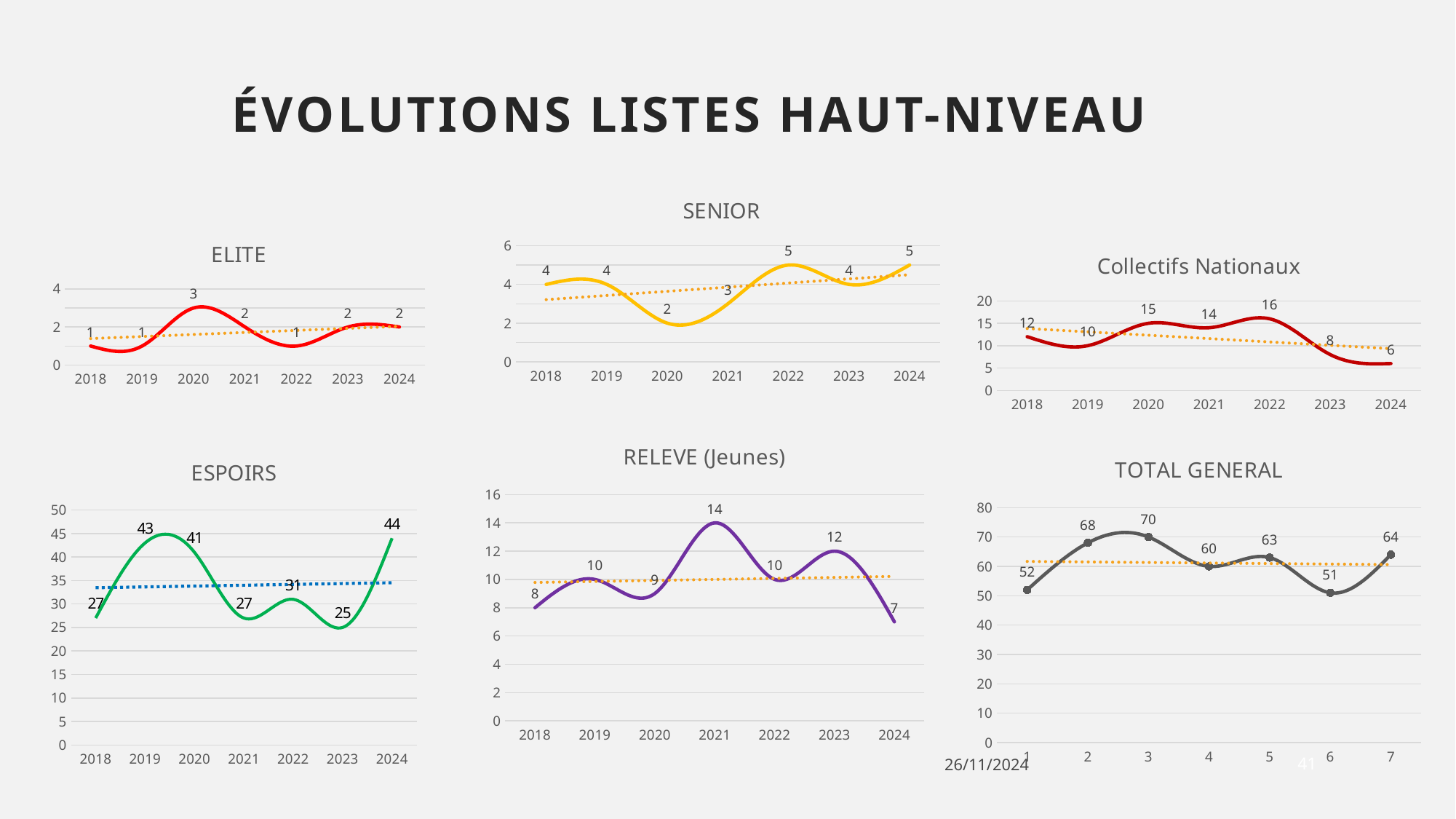
In the TOTAL GENERAL chart, what is the difference between the value at point 3 and the value at point 6? 19 In the ESPOIRS chart, what is the value for 2023? 25 In the TOTAL GENERAL chart, what is the highest value shown? 70 How many data points are plotted in the SENIOR chart? 7 What type of chart is the ESPOIRS chart? Line chart In the SENIOR chart, which year has the lowest value? 2020 In the Collectifs Nationaux chart, what is the difference between the 2022 value and the 2024 value? 10 In the RELEVE (Jeunes) chart, what is the value for 2024? 7 In the ELITE chart, what is the value for 2020? 3 In the Collectifs Nationaux chart, what is the value for 2022? 16 In the RELEVE (Jeunes) chart, which is larger, the value for 2021 or the value for 2023? 2021 In the ESPOIRS chart, which year has the highest value? 2024